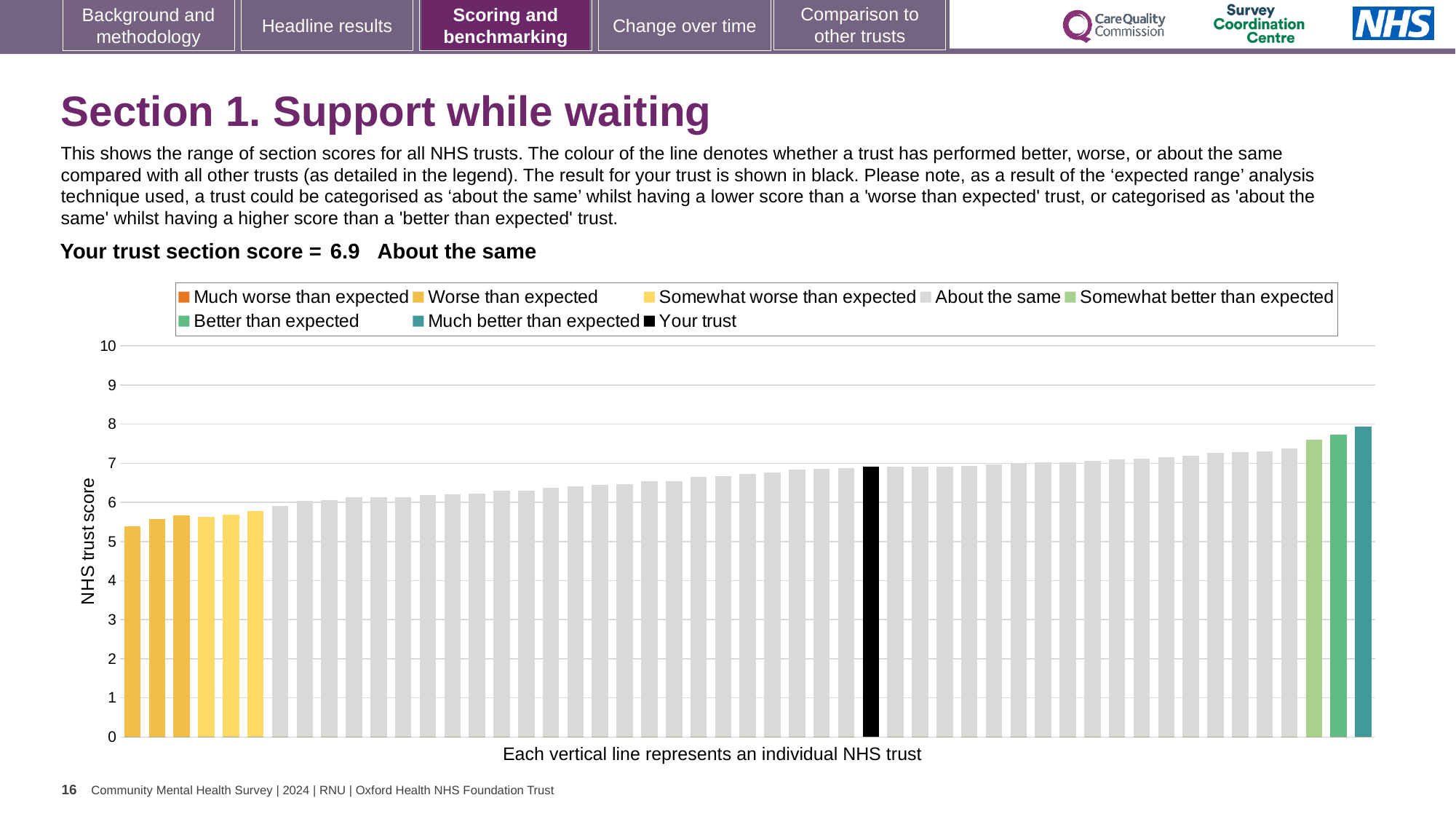
How many entries does the chart legend list? 8 How many yellow-coloured bars are at the left end of the chart? 6 Do the bar values rise or fall from left to right along the x axis? rise Is the value of the black bar (your trust) greater or less than 6? greater How many green-coloured bars are at the right end of the chart? 3 Which performance category is your trust placed in according to the slide? About the same What does the text below the x axis say each vertical line represents? an individual NHS trust What is the label on the vertical axis of the chart? NHS trust score What kind of chart is shown on the slide? bar chart What is the section score for your trust shown on the slide? 6.9 Is the value of the leftmost (lowest) bar greater or less than 6? less